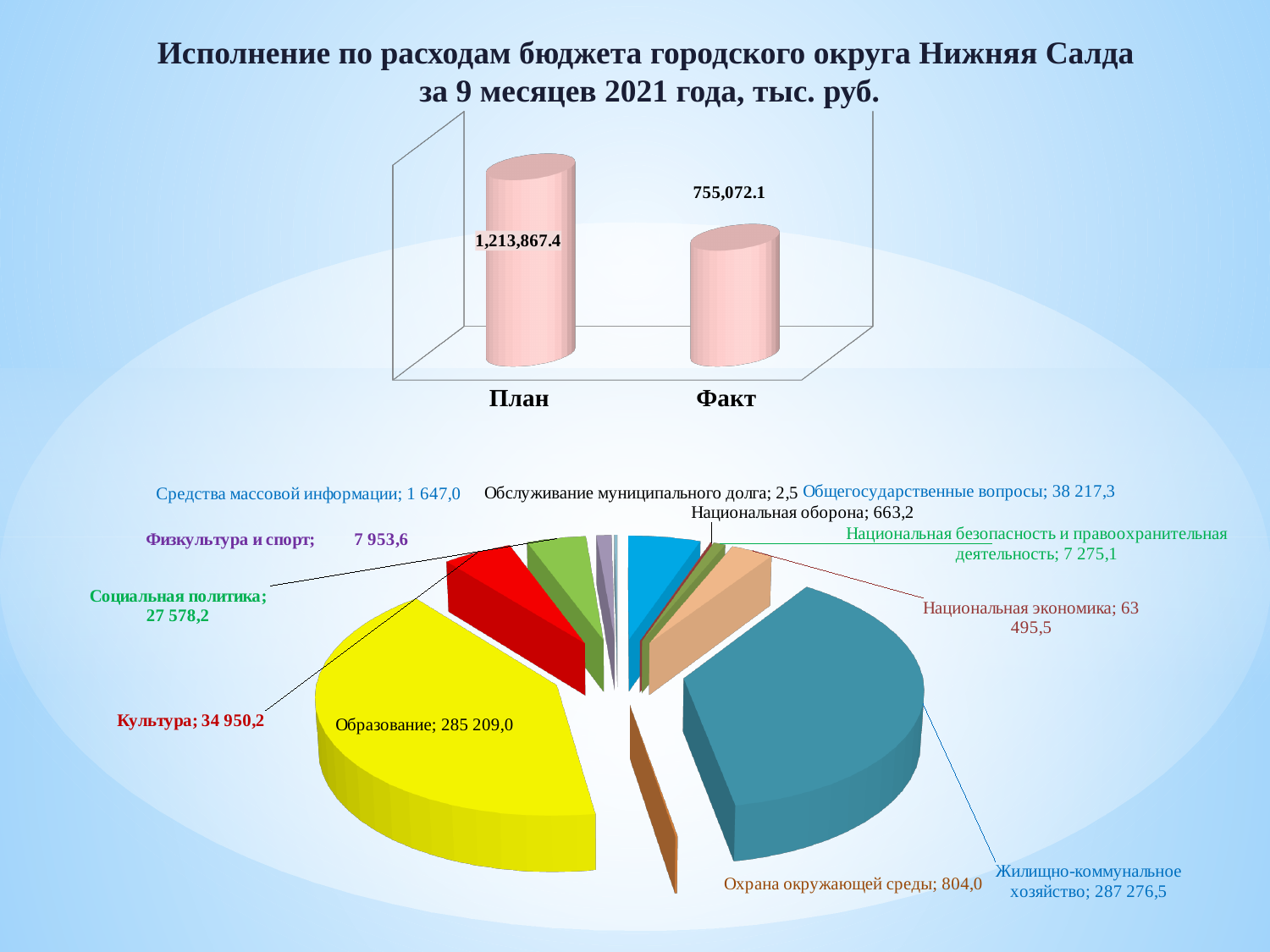
In the bottom pie chart, what is the value for Образование? 285 209,0 In the bottom pie chart, which category has the smallest value? Обслуживание муниципального долга In the bottom pie chart, what is the value for Жилищно-коммунальное хозяйство? 287 276,5 In the bottom pie chart, what is the difference between Образование and Культура? 250 258,8 In the top bar chart, what is the difference between План and Факт? 458,795.3 In the top bar chart, which is larger, План or Факт? План In the top bar chart, what is the value for План? 1,213,867.4 In the top bar chart, what is the value for Факт? 755,072.1 What kind of chart is the bottom chart on the slide? Pie chart How many categories are shown in the bottom pie chart? 12 In the bottom pie chart, which is larger, Культура or Социальная политика? Культура What kind of chart is the top chart on the slide? Bar chart